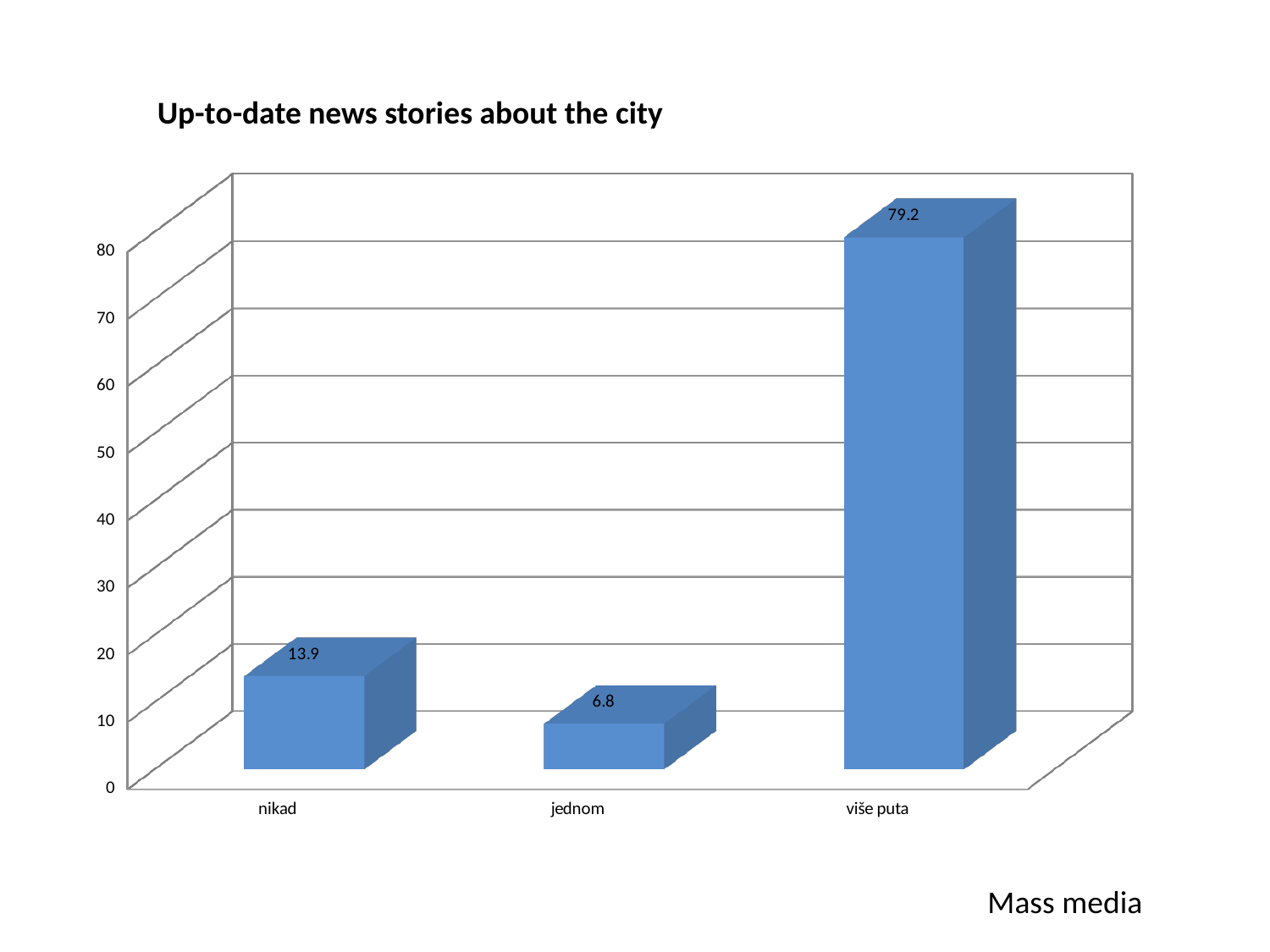
What is the value for "jednom"? 6.8 Which category has the lowest value? jednom Which category has the highest value? više puta What is the difference between the values for "više puta" and "nikad"? 65.3 What is the title of the chart? Up-to-date news stories about the city What is the value for "više puta"? 79.2 Which is larger, the value for "nikad" or the value for "jednom"? nikad How many categories are shown on the x axis? 3 Is the value for "više puta" greater or less than 70? greater What is the difference between the values for "nikad" and "jednom"? 7.1 What kind of chart is shown on the slide? bar chart What is the value for "nikad"? 13.9